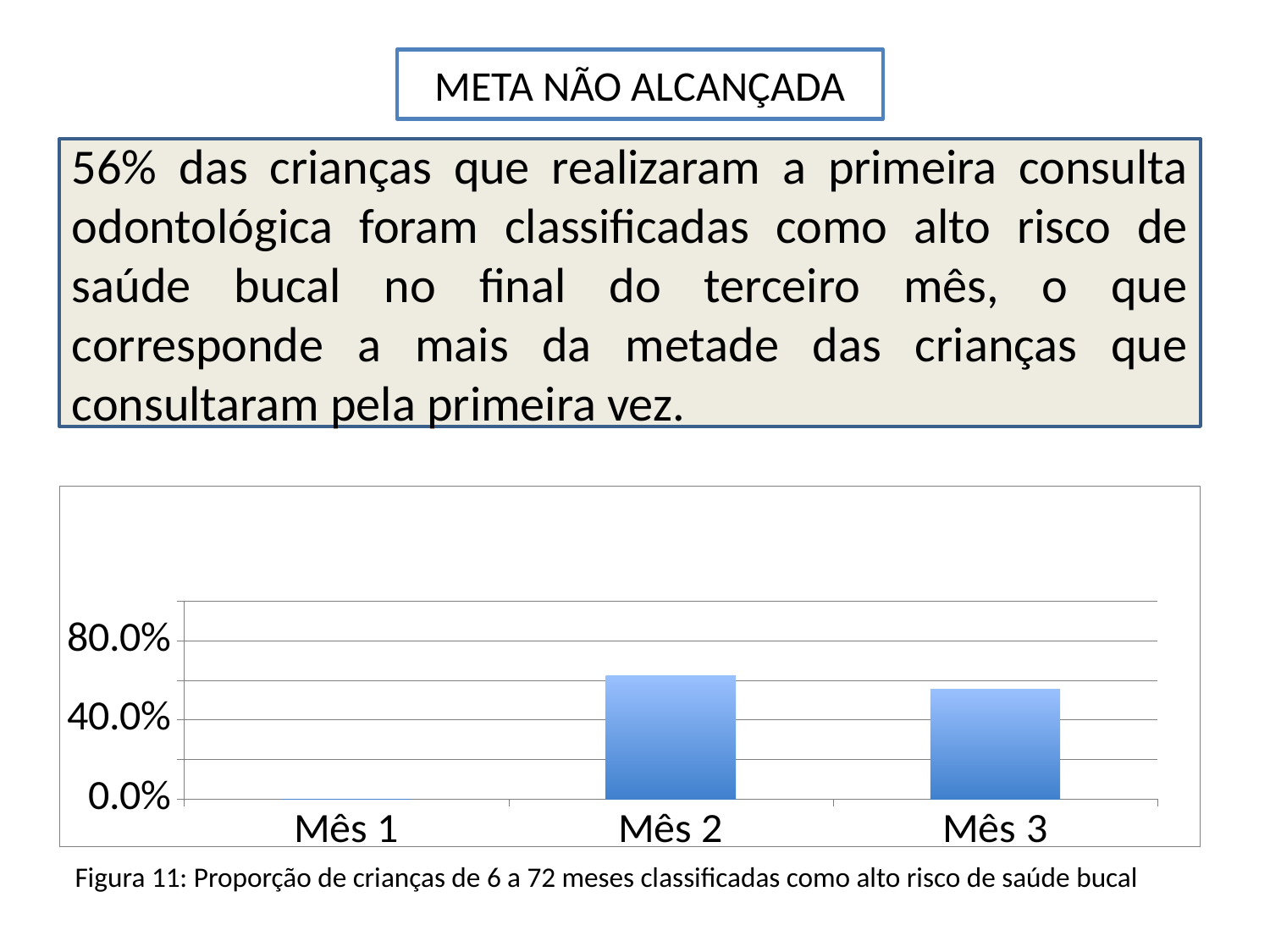
Which month has the highest proportion of children classified as high oral health risk? Mês 2 Which month has the lowest value in the chart? Mês 1 Is the value for Mês 2 greater or less than 80.0%? less Is the value for Mês 2 greater or less than 40.0%? greater Is the value for Mês 1 greater or less than 40.0%? less What is the figure number given in the caption below the chart? Figura 11 How many categories (months) are shown on the x axis of the chart? 3 Does the value rise or fall from Mês 2 to Mês 3? fall According to the slide text, what proportion of children were classified as high oral health risk at the end of the third month (Mês 3)? 56% What kind of chart is shown on the slide? bar chart Which is larger, the value for Mês 2 or the value for Mês 3? Mês 2